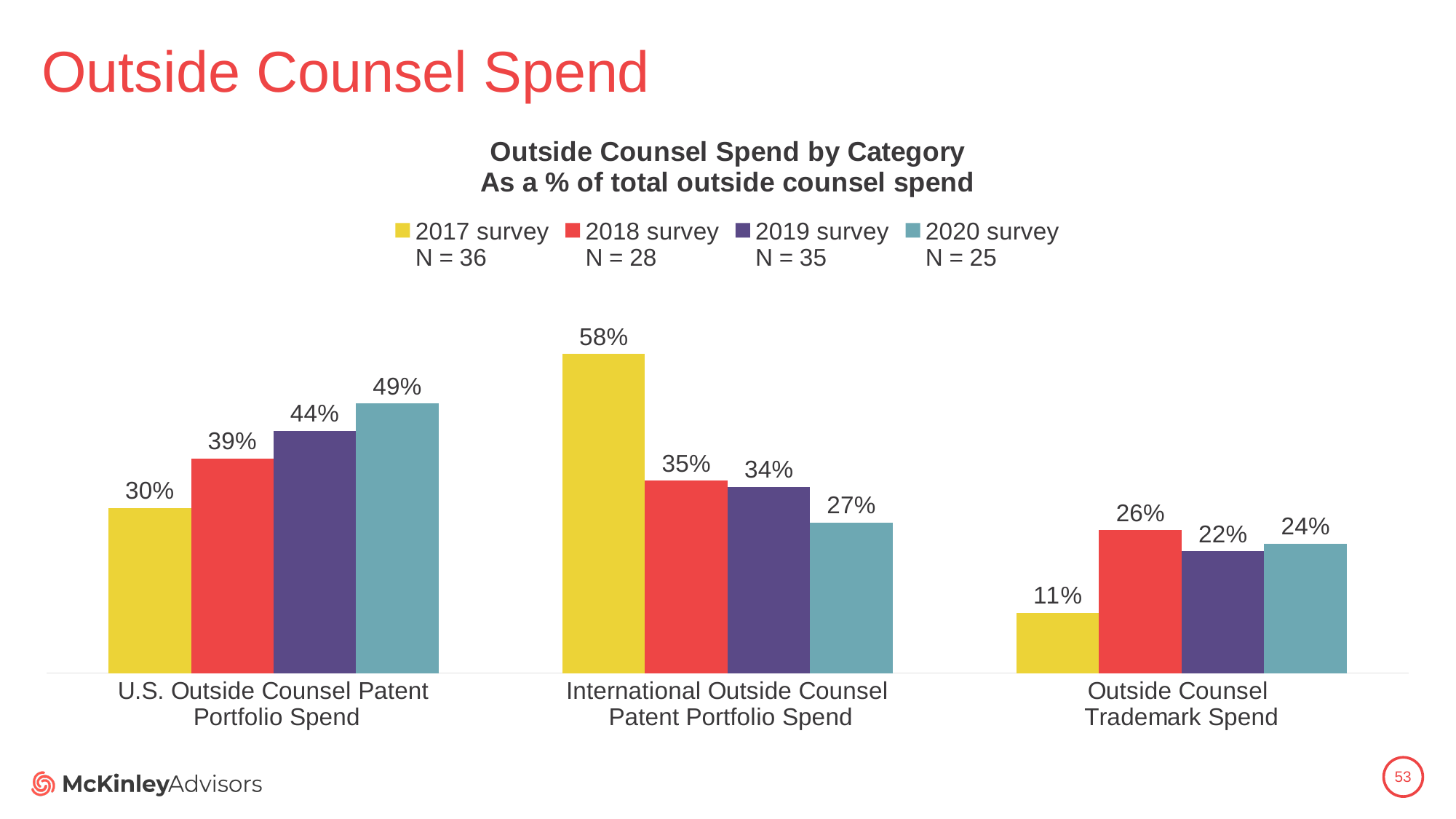
Do the values for U.S. Outside Counsel Patent Portfolio Spend rise or fall from the 2017 survey to the 2020 survey? Rise What kind of chart is shown? Bar chart What is the 2020 survey value for U.S. Outside Counsel Patent Portfolio Spend? 49% How many categories are shown on the x axis? 3 What is the 2018 survey value for Outside Counsel Trademark Spend? 26% Which category has the lowest 2020 survey value? Outside Counsel Trademark Spend What is the difference between the 2020 survey and 2017 survey values for U.S. Outside Counsel Patent Portfolio Spend? 19% How many series does the legend list? 4 What is the sample size (N) shown for the 2018 survey in the legend? N = 28 Which is larger for Outside Counsel Trademark Spend: the 2019 survey value or the 2020 survey value? 2020 survey Which category has the highest 2017 survey value? International Outside Counsel Patent Portfolio Spend What is the 2017 survey value for International Outside Counsel Patent Portfolio Spend? 58%